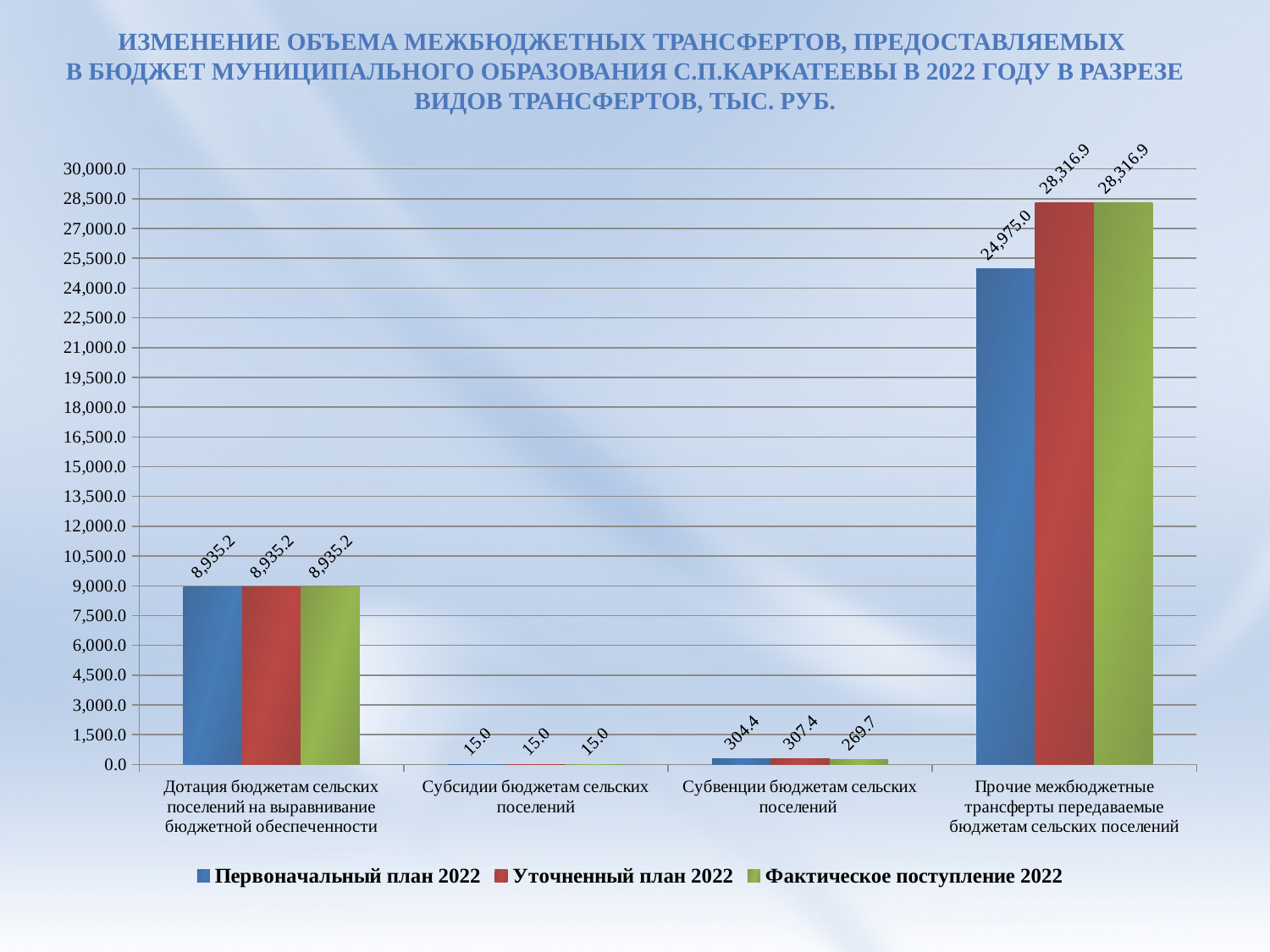
For Субвенции бюджетам сельских поселений, which is larger: Уточненный план 2022 or Фактическое поступление 2022? Уточненный план 2022 Which series is shown in green in the legend? Фактическое поступление 2022 What is the difference between Уточненный план 2022 and Первоначальный план 2022 for Прочие межбюджетные трансферты передаваемые бюджетам сельских поселений? 3,341.9 What is the value of Фактическое поступление 2022 for Дотация бюджетам сельских поселений на выравнивание бюджетной обеспеченности? 8,935.2 What type of chart is shown on the slide? bar chart How many series does the legend list? 3 What is the value of Первоначальный план 2022 for Субсидии бюджетам сельских поселений? 15.0 Which category has the lowest value for Фактическое поступление 2022? Субсидии бюджетам сельских поселений How many categories are shown on the x axis? 4 Which category has the highest value for Уточненный план 2022? Прочие межбюджетные трансферты передаваемые бюджетам сельских поселений What is the value of Уточненный план 2022 for Субвенции бюджетам сельских поселений? 307.4 What is the value of Первоначальный план 2022 for Прочие межбюджетные трансферты передаваемые бюджетам сельских поселений? 24,975.0